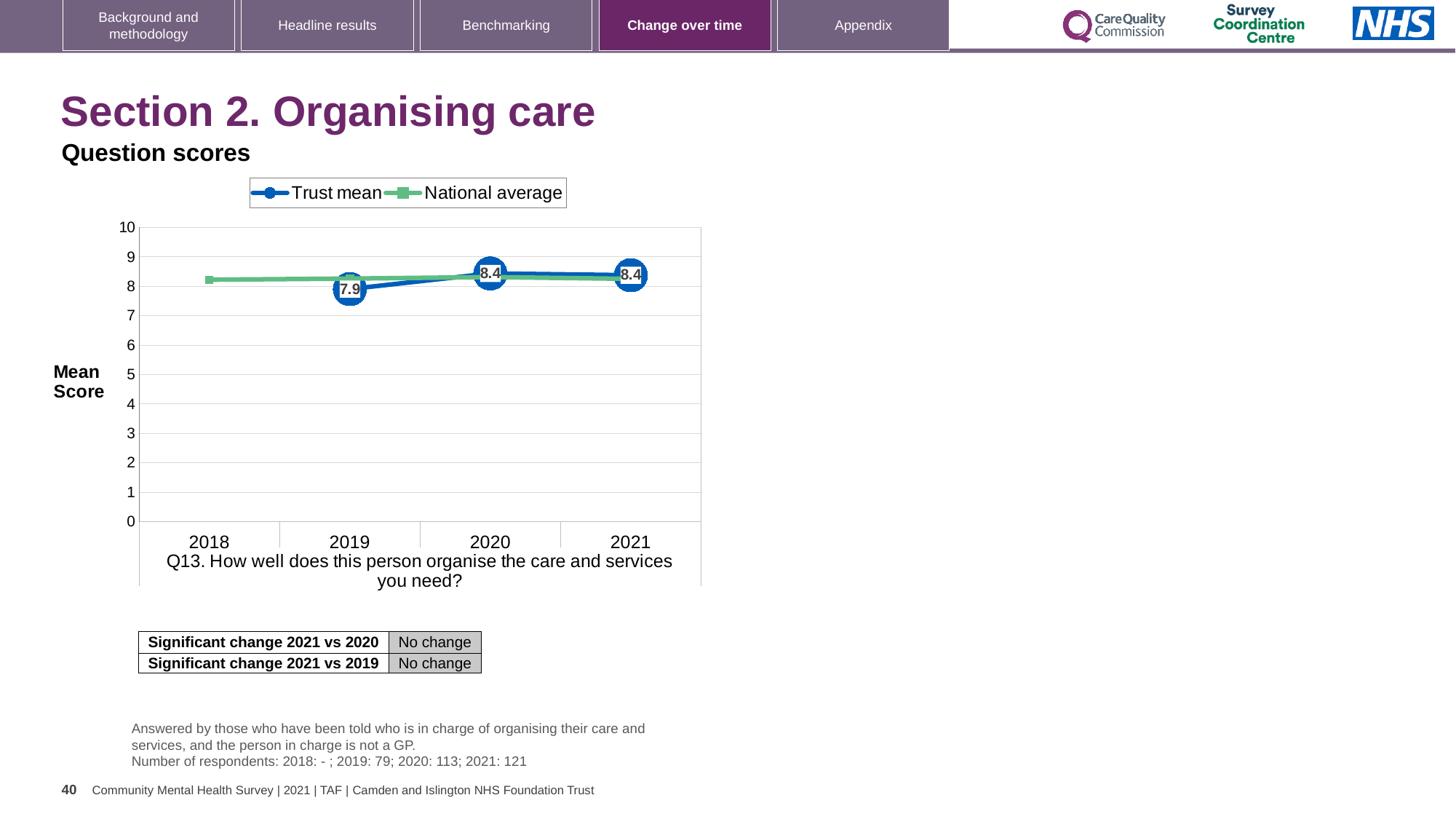
What is the Trust mean score for 2020? 8.4 What is the label on the y axis of the chart? Mean Score Which is larger, the Trust mean for 2019 or the Trust mean for 2020? 2020 How many series does the legend list? 2 What is the Trust mean score for 2021? 8.4 By how much did the Trust mean score change from 2019 to 2020? 0.5 Does the Trust mean score rise or fall from 2019 to 2020? Rise In which year is the Trust mean score lowest? 2019 What is the Trust mean score for 2019? 7.9 How many years are shown on the x axis? 4 What kind of chart is shown on the slide? Line chart Is the National average value for 2018 greater or less than 7? greater